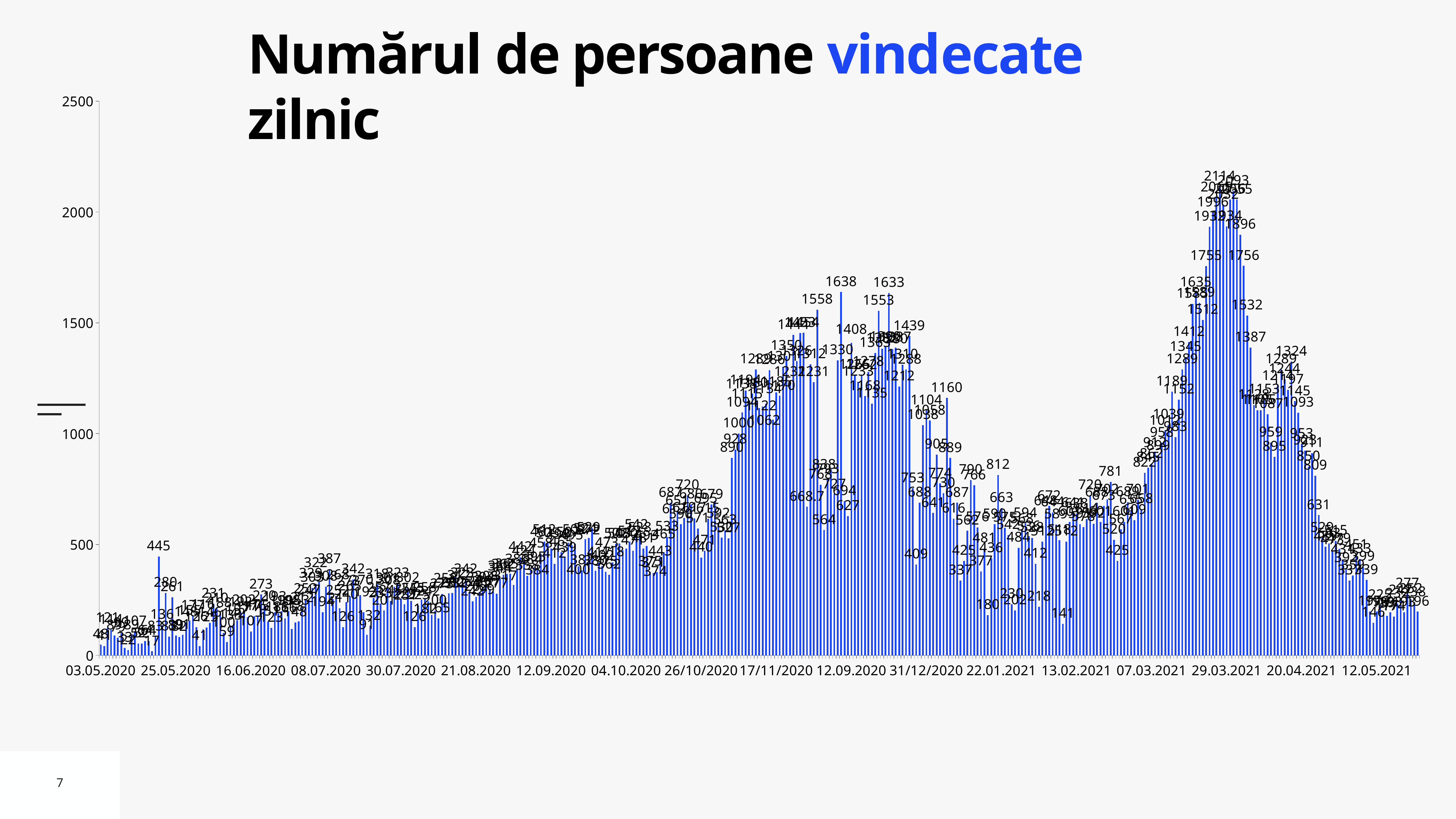
What is the highest value shown on the vertical axis? 2500 Do the values rise or fall between 29.03.2021 and 12.05.2021? fall Is the value for 29.03.2021 greater or less than 1500? greater Is the value of the tallest bar greater or less than 2000? greater Is the value for 03.05.2020 greater or less than 500? less Do the values rise or fall between 07.03.2021 and 29.03.2021? rise What is the value of the tallest bar in the chart? 2114 Which is larger, the value for 29.03.2021 or the value for 12.05.2021? 29.03.2021 What is the title of the chart? Numărul de persoane vindecate zilnic What kind of chart is shown on the slide? bar chart